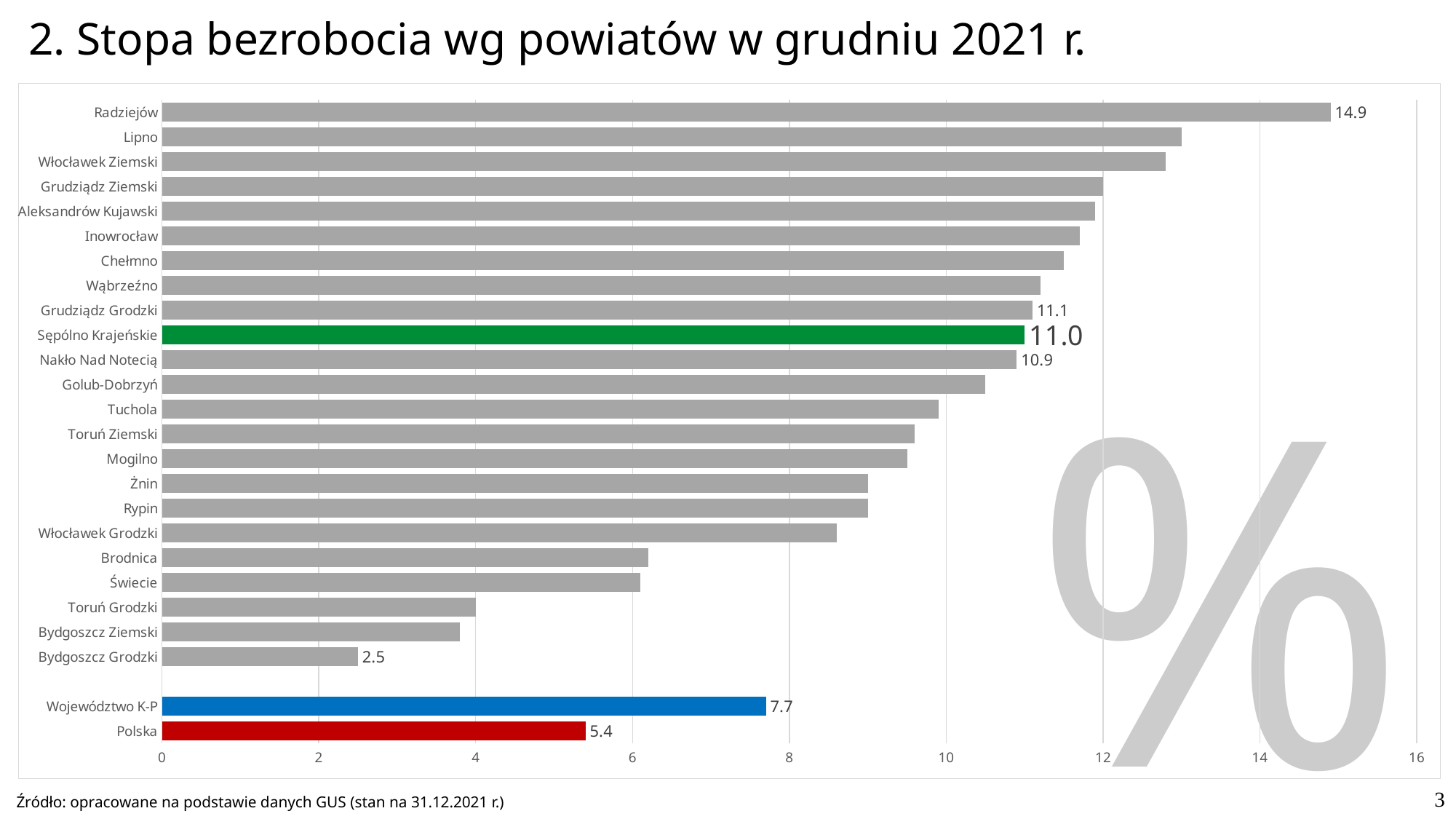
What value is shown for Polska? 5.4 What value is shown for Sępólno Krajeńskie? 11.0 What type of chart is shown on the slide? bar chart Which powiat has the highest unemployment rate on the chart? Radziejów What is the unemployment rate shown for Radziejów? 14.9 Is the value for Lipno greater or less than 12? greater What is the difference between the values for Województwo K-P and Polska? 2.3 Which powiat has the lowest unemployment rate on the chart? Bydgoszcz Grodzki What is the difference between the values for Radziejów and Bydgoszcz Grodzki? 12.4 What value is shown for Województwo K-P? 7.7 Which is larger, the value for Grudziądz Grodzki or the value for Nakło Nad Notecią? Grudziądz Grodzki